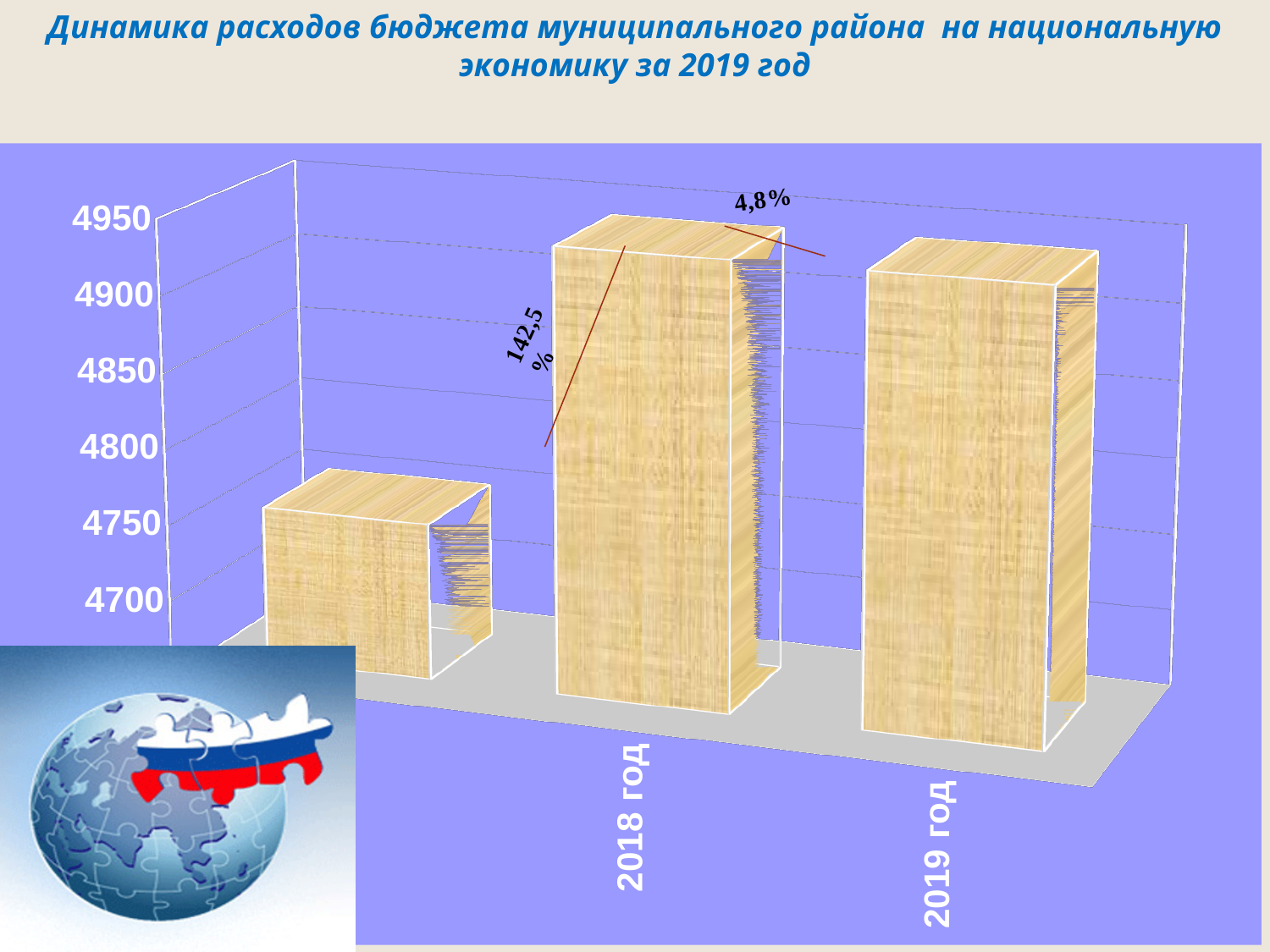
Is the value for 2018 год greater or less than 4900? greater How many bars are plotted in the chart? 3 What is the highest value shown on the vertical axis? 4950 What kind of chart is shown on the slide? bar chart What percentage is written in the annotation next to the top of the 2018 год bar? 4,8 % Is the value for 2019 год greater or less than 4850? greater What is the lowest value shown on the vertical axis? 4700